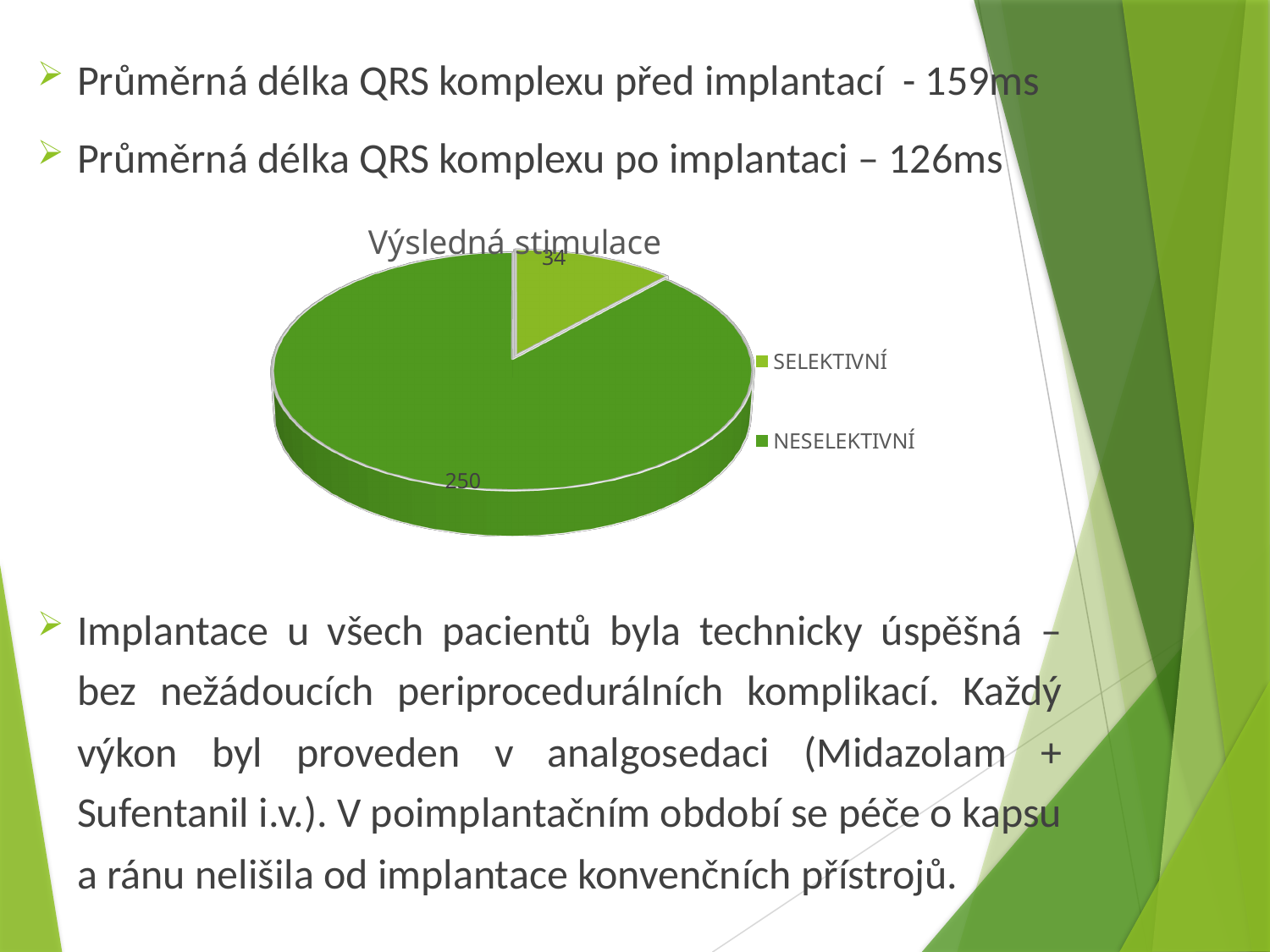
What is the title of the chart? Výsledná stimulace Which category has the smallest slice in the pie chart? SELEKTIVNÍ What is the value for NESELEKTIVNÍ in the pie chart? 250 Which is larger, SELEKTIVNÍ or NESELEKTIVNÍ? NESELEKTIVNÍ What is the total of all slices in the pie chart? 284 Which legend entry is shown in the lighter green colour? SELEKTIVNÍ What is the value for SELEKTIVNÍ in the pie chart? 34 Which category has the largest slice in the pie chart? NESELEKTIVNÍ How many categories does the pie chart show? 2 What type of chart is shown on the slide? Pie chart What is the difference between the NESELEKTIVNÍ and SELEKTIVNÍ values? 216